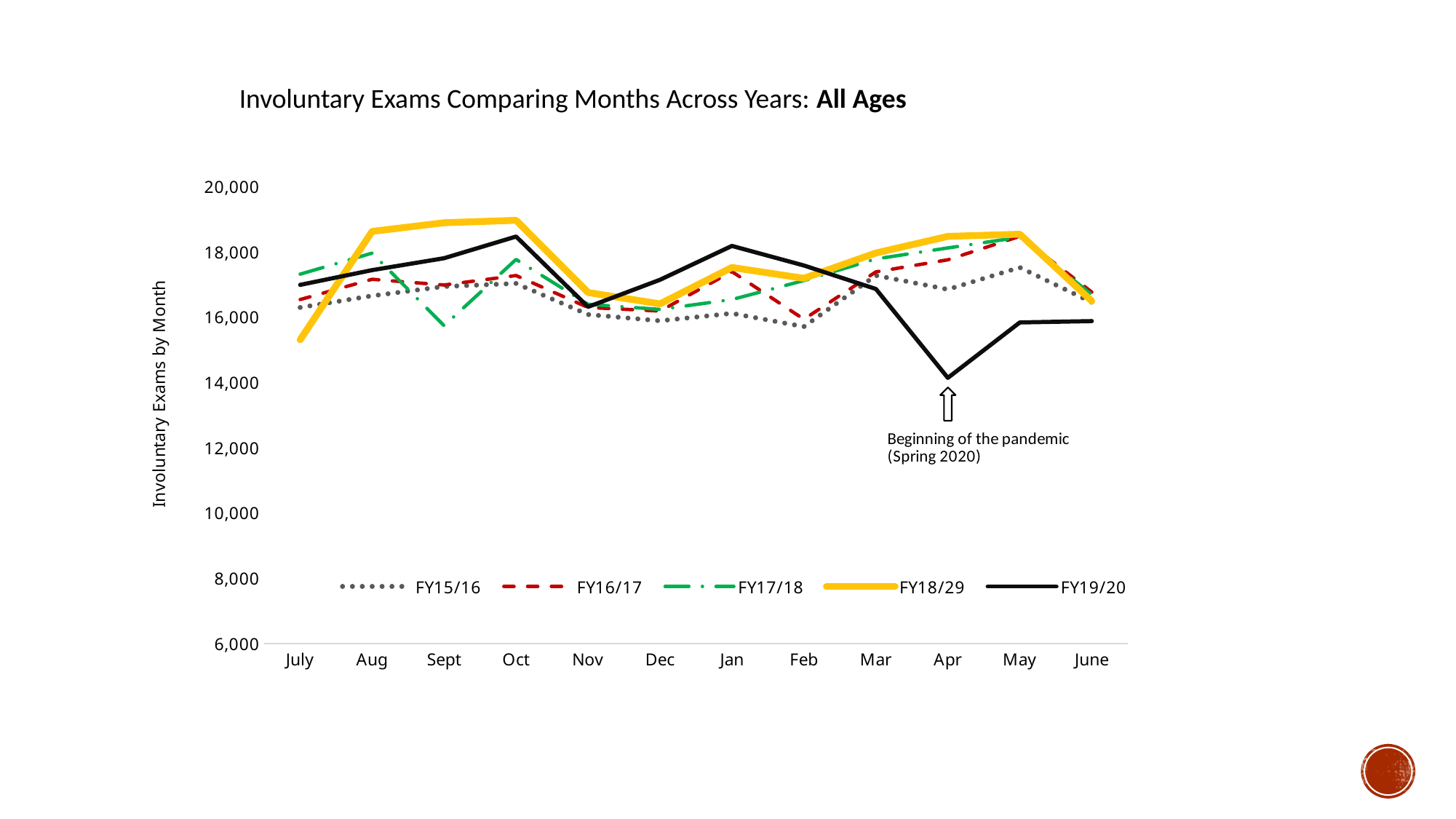
Which series has the lowest value in July? FY18/29 What event does the annotation with the arrow near Apr mark? Beginning of the pandemic (Spring 2020) How many months are shown along the x axis? 12 Is the FY18/29 value for July greater or less than 16,000? less What kind of chart is shown on the slide? Line chart Does the FY19/20 series rise or fall from Mar to Apr? Fall Which is larger in Apr, the FY18/29 value or the FY19/20 value? FY18/29 Which series has the lowest value in Apr? FY19/20 Is the FY19/20 value for Apr greater or less than 16,000? less Is the FY18/29 value for Oct greater or less than 18,000? greater How many series does the legend list? 5 In which month does the FY19/20 series reach its lowest value? Apr